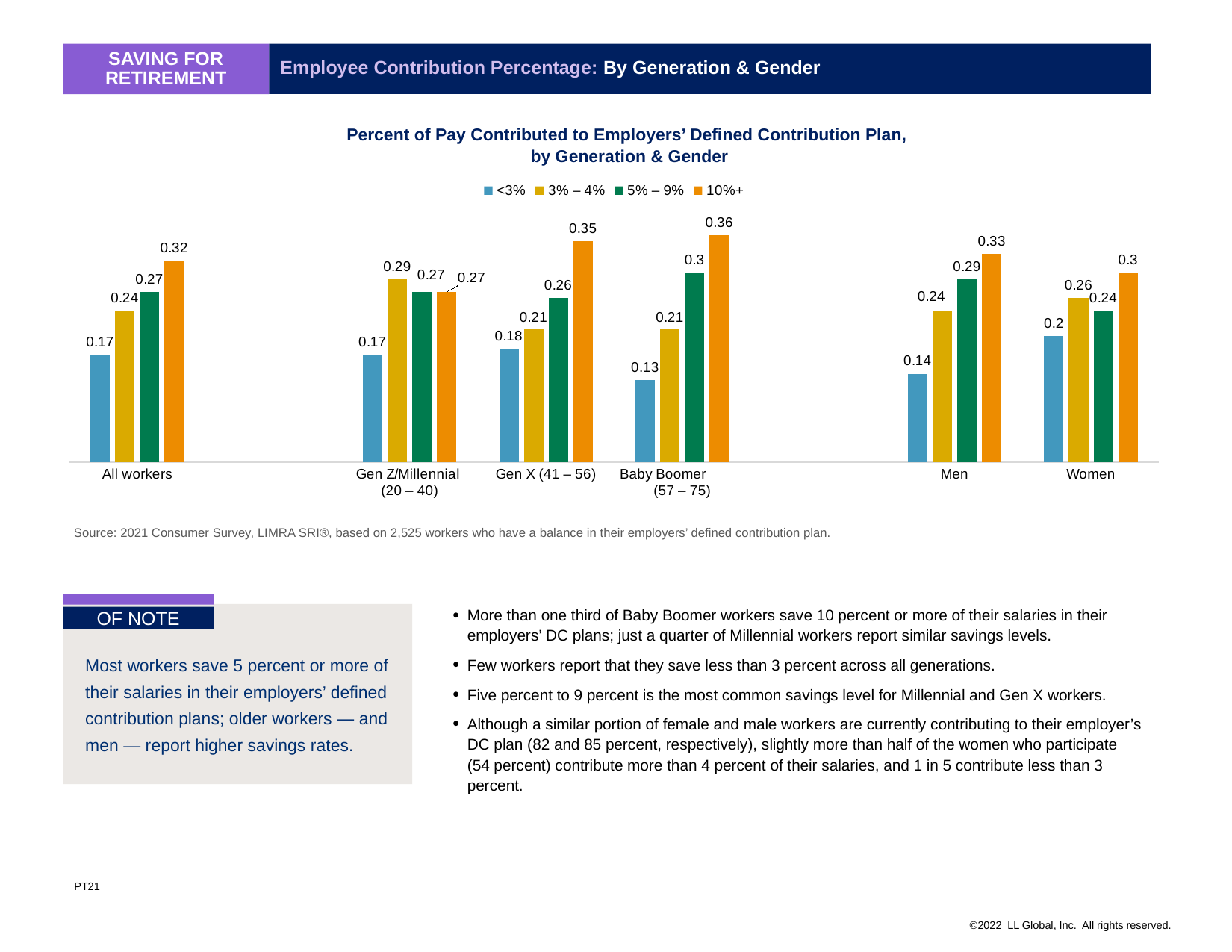
Which category has the lowest value for the <3% series? Baby Boomer (57 – 75) What is the value for the 3% – 4% series for Gen Z/Millennial (20 – 40)? 0.29 What is the value for the 10%+ series for Baby Boomer (57 – 75)? 0.36 How many categories are shown on the x axis? 6 What kind of chart is shown on the slide? Bar chart What is the value for the <3% series for Women? 0.2 How many series does the legend list? 4 Which is larger: the 5% – 9% value for Men or the 5% – 9% value for Women? Men Which category has the highest value for the 10%+ series? Baby Boomer (57 – 75) What is the difference between the 10%+ value and the <3% value for All workers? 0.15 Which series is shown in orange in the legend? 10%+ What is the difference between the 10%+ values for Men and Women? 0.03